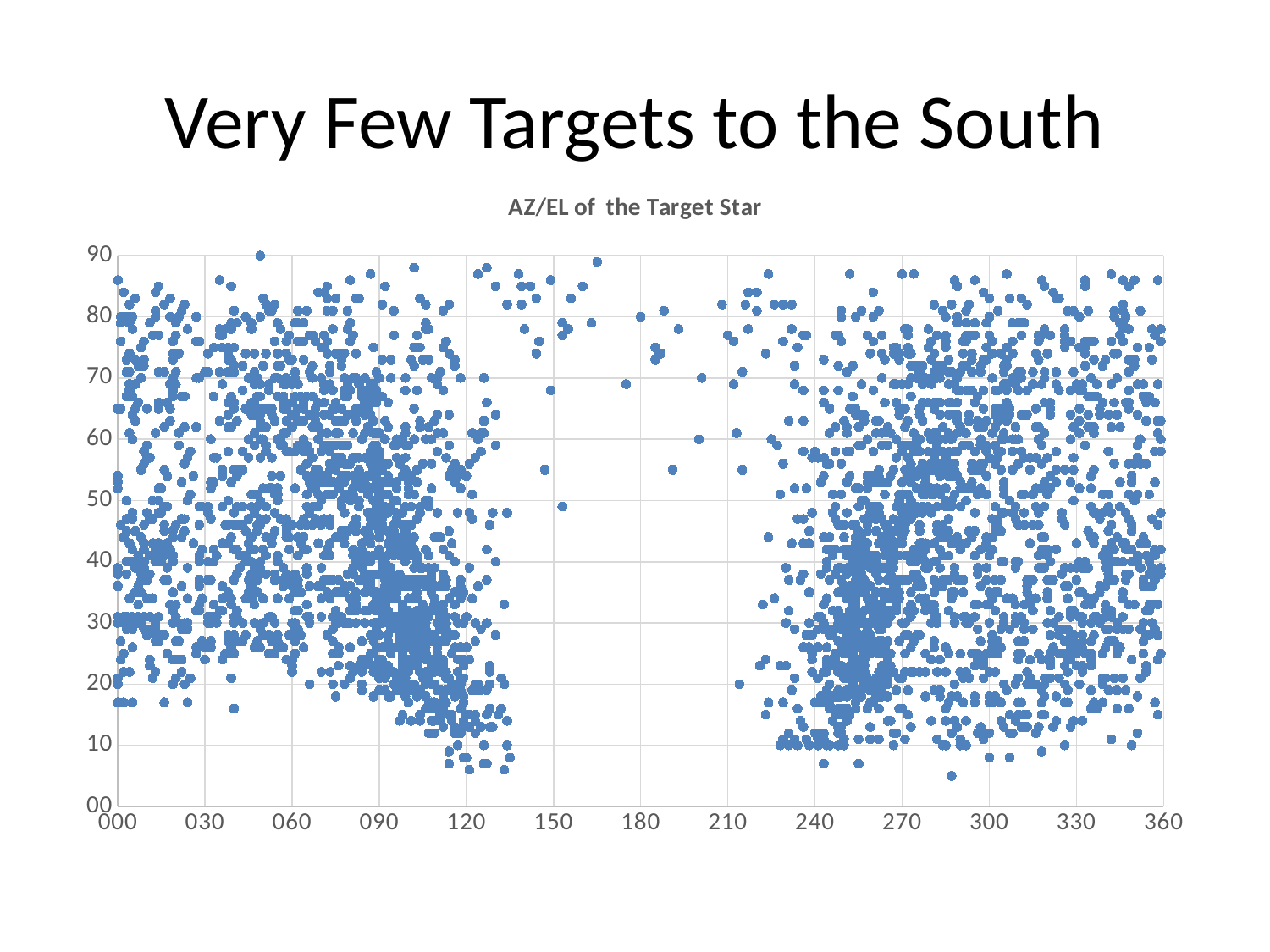
Is the lowest elevation value plotted on the chart greater or less than 10? less Which azimuth range has the fewest plotted points: 000-120, 150-210, or 240-360? 150-210 What is the largest tick value shown on the x axis of the chart? 360 Is the highest elevation value plotted on the chart greater or less than 80? greater What is the title of the chart? AZ/EL of the Target Star Are there more points plotted between azimuth 150 and 210 or between azimuth 240 and 300? between 240 and 300 What kind of chart is shown on the slide? scatter chart Are there more points plotted between azimuth 060 and 120 or between azimuth 120 and 180? between 060 and 120